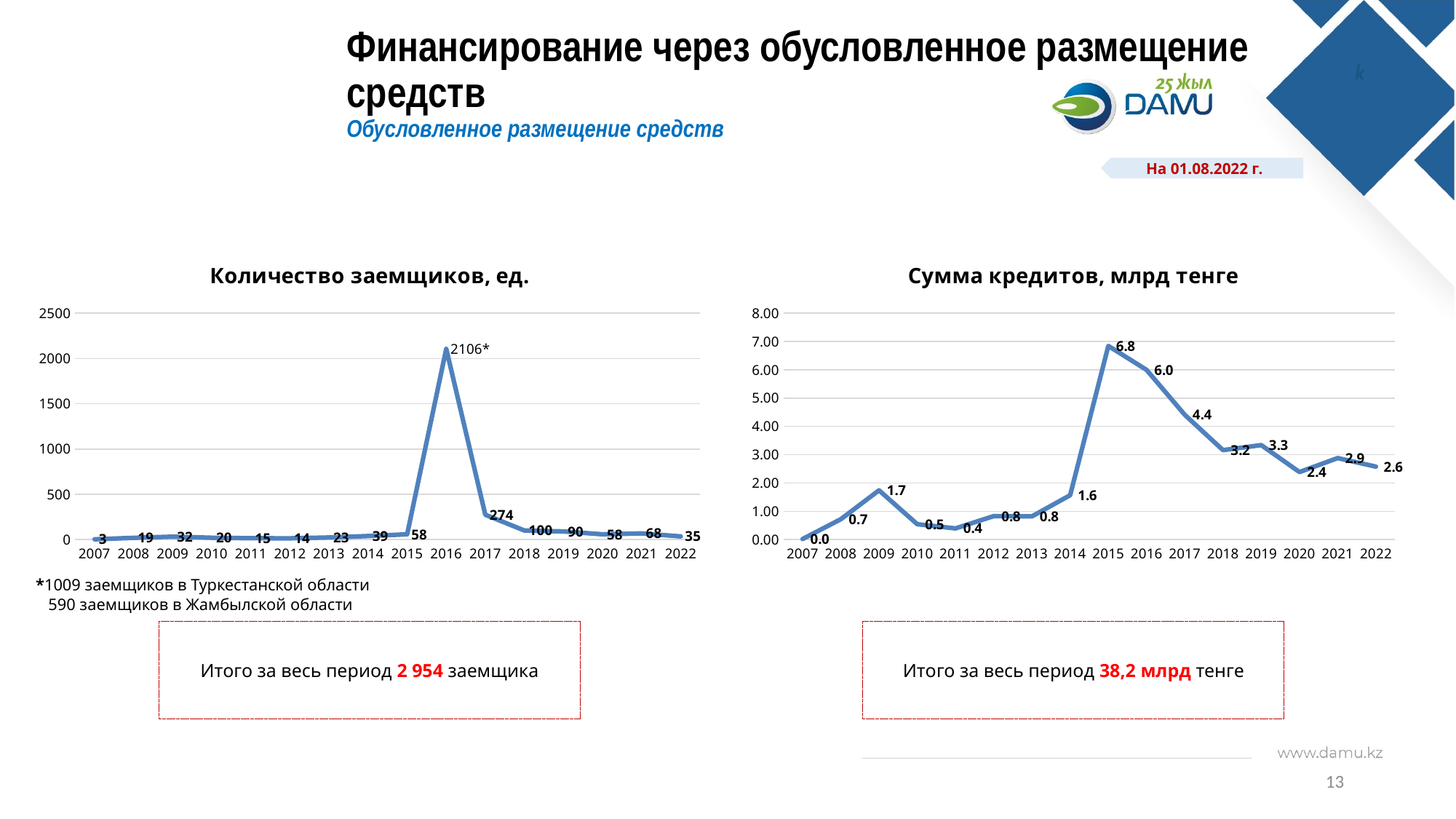
What type of chart is 'Количество заемщиков, ед.'? Line chart In the chart 'Количество заемщиков, ед.', what is the difference between the values for 2018 and 2019? 10 In the chart 'Сумма кредитов, млрд тенге', what is the difference between the values for 2015 and 2016? 0.8 In the chart 'Сумма кредитов, млрд тенге', what is the value for 2015? 6.8 In the chart 'Количество заемщиков, ед.', which year has the lowest value? 2007 In the chart 'Сумма кредитов, млрд тенге', what is the value for 2009? 1.7 In the chart 'Количество заемщиков, ед.', what is the value for 2017? 274 In the chart 'Сумма кредитов, млрд тенге', which is larger, the value for 2018 or the value for 2020? 2018 In the chart 'Количество заемщиков, ед.', how many years are plotted on the x axis? 16 In the chart 'Сумма кредитов, млрд тенге', do the values rise or fall from 2016 to 2018? Fall In the chart 'Количество заемщиков, ед.', which year has the highest value? 2016 What is the title of the chart on the right side of the slide? Сумма кредитов, млрд тенге